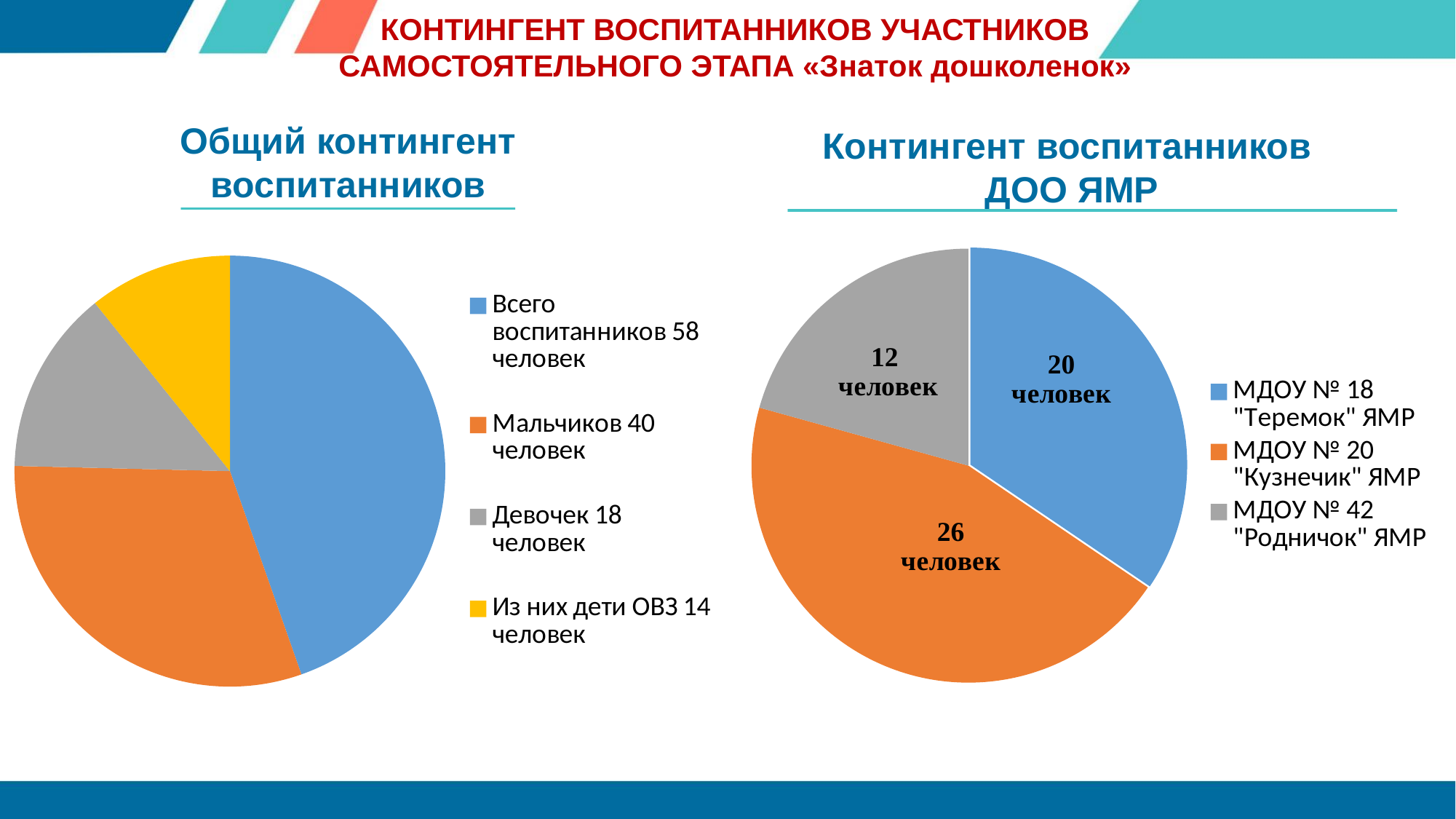
In the "Контингент воспитанников ДОО ЯМР" chart on the right, which institution has the largest slice? МДОУ № 20 "Кузнечик" ЯМР In the "Контингент воспитанников ДОО ЯМР" chart on the right, how many people are shown for МДОУ № 20 "Кузнечик" ЯМР? 26 человек In the "Общий контингент воспитанников" chart on the left, how many girls (Девочек) are listed in the legend? 18 человек In the "Контингент воспитанников ДОО ЯМР" chart on the right, how many people are shown for МДОУ № 42 "Родничок" ЯМР? 12 человек In the "Контингент воспитанников ДОО ЯМР" chart on the right, what is the difference between the values for МДОУ № 20 "Кузнечик" ЯМР and МДОУ № 18 "Теремок" ЯМР? 6 человек In the "Контингент воспитанников ДОО ЯМР" chart on the right, which institution has the smallest slice? МДОУ № 42 "Родничок" ЯМР In the "Общий контингент воспитанников" chart on the left, what colour is the slice for "Из них дети ОВЗ 14 человек"? Yellow In the "Общий контингент воспитанников" chart on the left, how many boys (Мальчиков) are listed in the legend? 40 человек In the "Общий контингент воспитанников" chart on the left, how many entries does the legend list? 4 What kind of chart is the "Общий контингент воспитанников" chart on the left? Pie chart In the "Общий контингент воспитанников" chart on the left, which is larger: Мальчиков or Девочек? Мальчиков In the "Контингент воспитанников ДОО ЯМР" chart on the right, how many slices does the pie have? 3